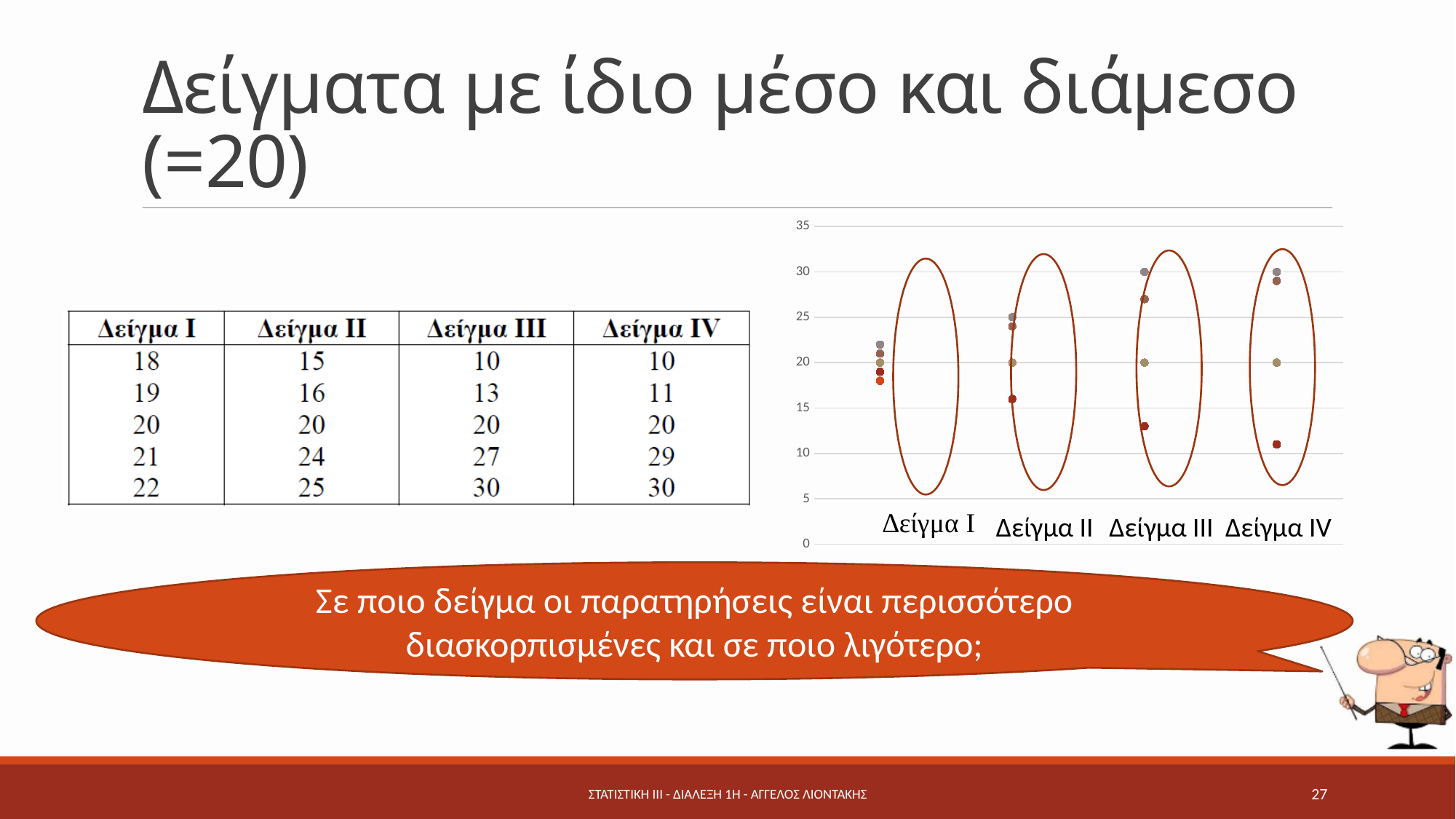
Is the lowest point of Δείγμα II greater or less than 20? less Which value appears in all four samples in the chart? 20 What is the highest tick value shown on the y axis of the chart? 35 What is the lowest value plotted for Δείγμα III? 10 Is the highest point of Δείγμα I greater or less than 25? less How many data points are plotted for Δείγμα III in the chart? 5 What kind of chart is shown on the right of the slide? scatter chart What is the lowest value plotted for Δείγμα IV? 11 Which sample has its points clustered most tightly together (least spread)? Δείγμα I What is the difference between the highest and lowest values of Δείγμα II? 10 How many samples (categories) are shown along the x axis of the chart? 4 What is the highest value plotted for Δείγμα III? 30